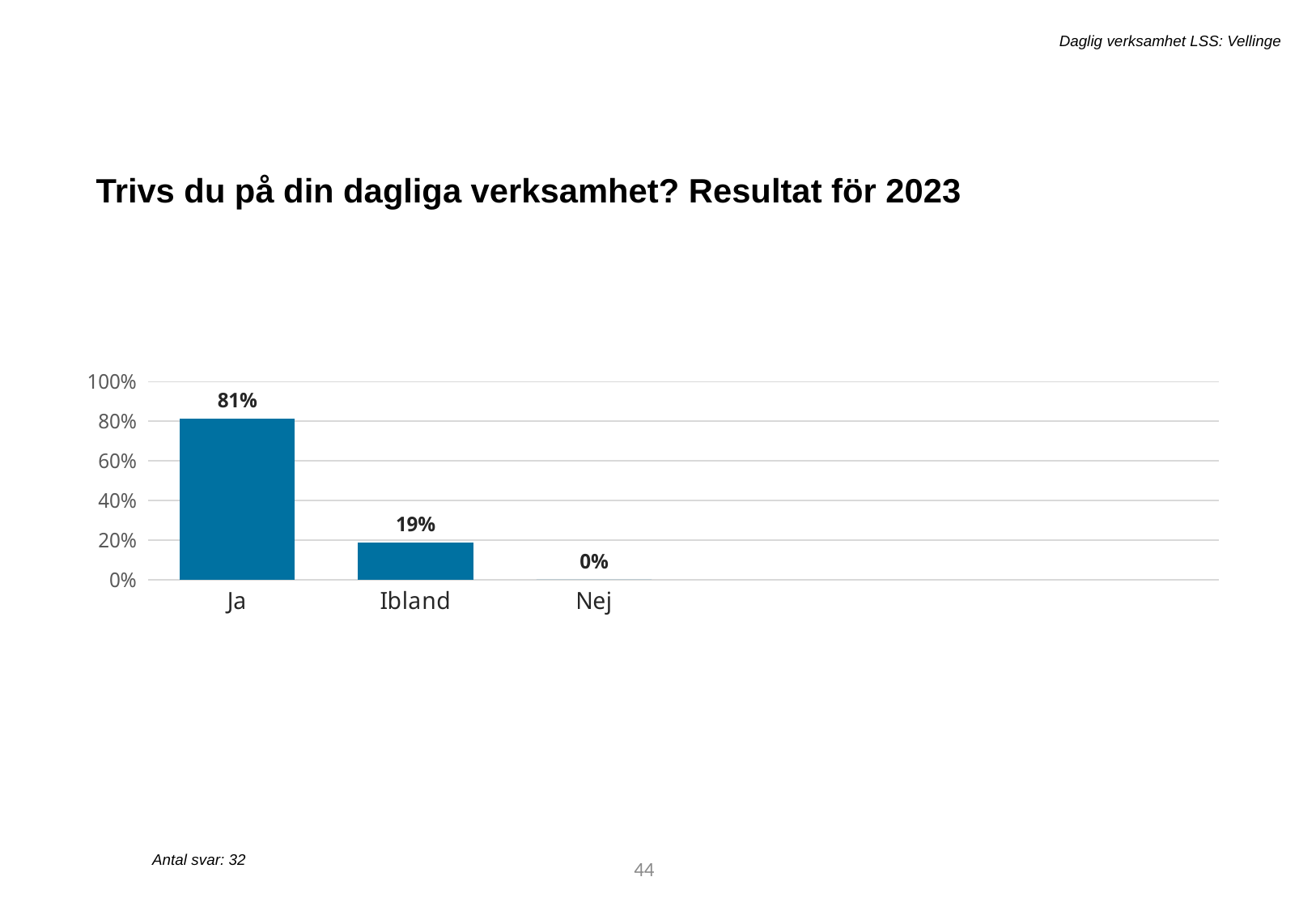
Which is larger, the value for Ibland or the value for Nej? Ibland What is the value for Ja? 81% How many categories are shown on the x axis? 3 Is the value for Ja greater or less than 60%? greater Which category has the highest value? Ja Do the values rise or fall from Ja to Nej along the x axis? fall What is the difference between the values for Ja and Ibland? 62% Which category has the lowest value? Nej What is the value for Ibland? 19% What kind of chart is shown on the slide? bar chart What is the value for Nej? 0% What is the title of the slide? Trivs du på din dagliga verksamhet? Resultat för 2023